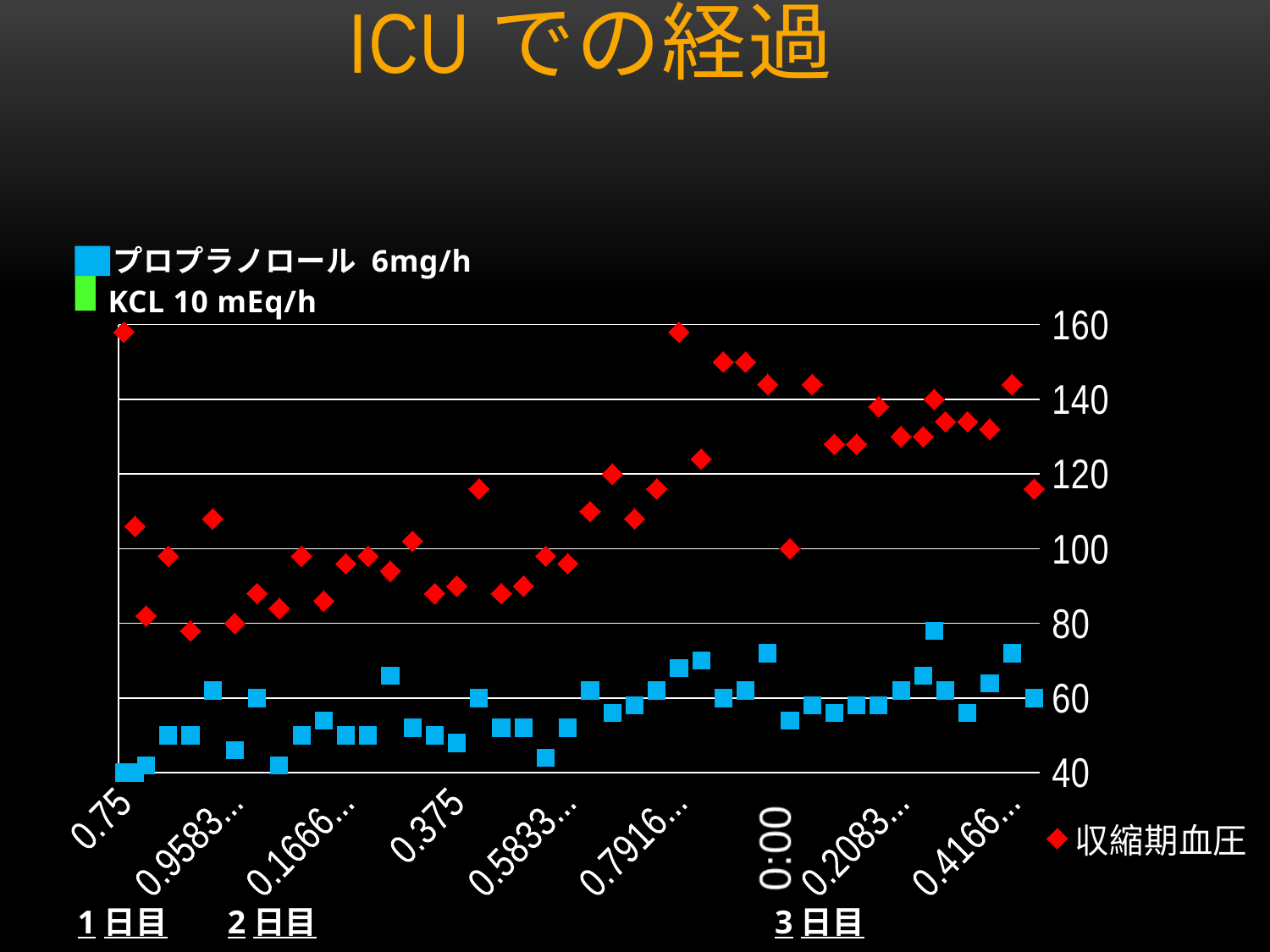
How many series does the chart legend list? 1 How many labels are shown along the horizontal axis? 9 What is the title of the slide chart? ICU での経過 Is the 収縮期血圧 value at the first x-axis label (0.75) greater or less than 140? greater Is the 収縮期血圧 value at the x-axis label 0:00 greater or less than 120? less What is the highest value shown on the vertical axis? 160 Do the blue square values generally rise or fall from left to right across the chart? rise What kind of chart is shown on the slide? scatter chart What is the lowest value shown on the vertical axis? 40 What series name appears in the chart legend? 収縮期血圧 Is the blue square value at the first x-axis label (0.75) greater or less than 60? less